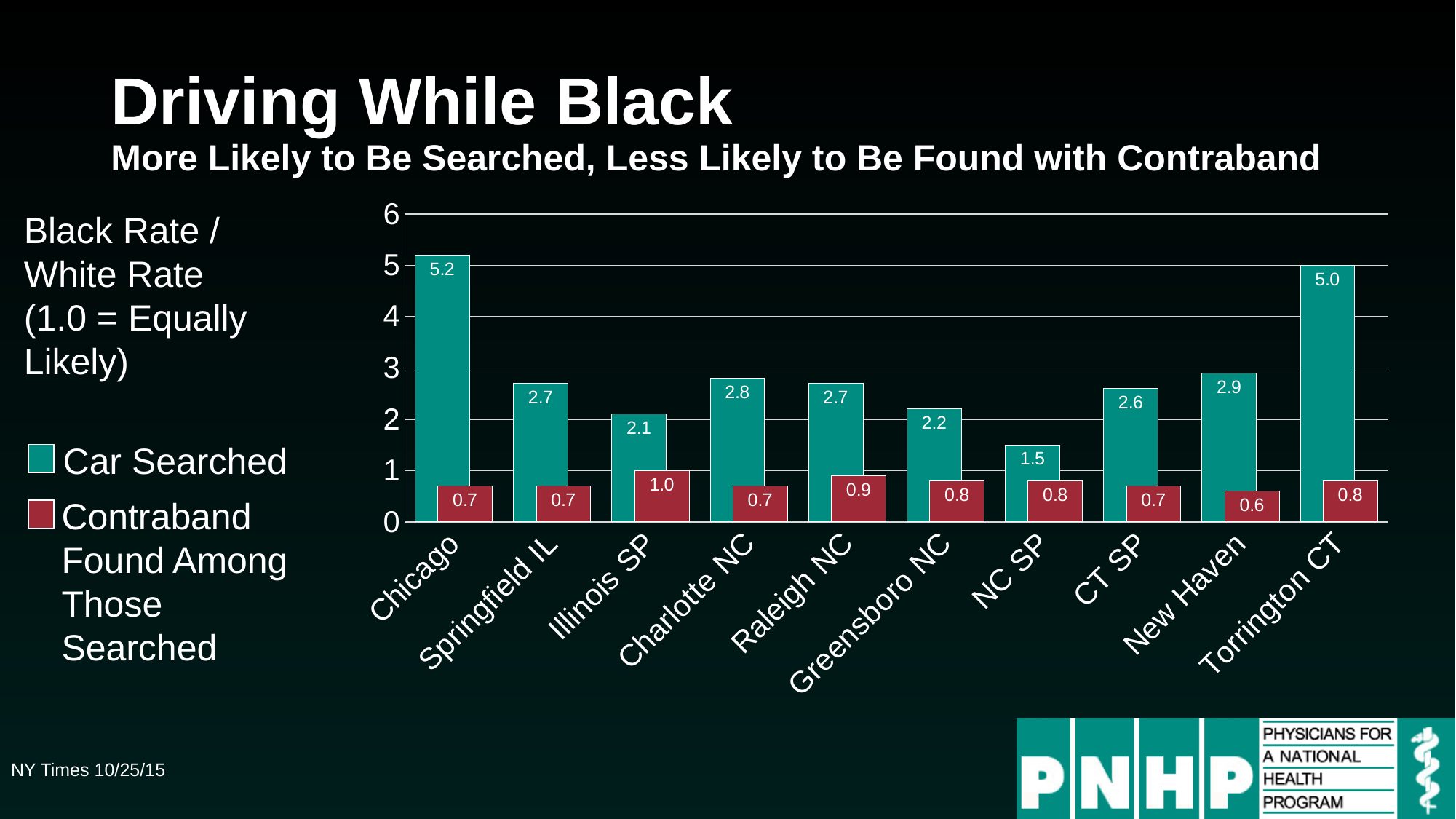
What is the Car Searched value for Chicago? 5.2 Which category has the lowest Contraband Found Among Those Searched value? New Haven Which category has the highest Car Searched value? Chicago What is the Car Searched value for New Haven? 2.9 Which category has the lowest Car Searched value? NC SP Which is larger, the Car Searched value for Charlotte NC or for Raleigh NC? Charlotte NC What is the difference between the Car Searched values for Chicago and Torrington CT? 0.2 How many series does the legend list? 2 What colour are the Car Searched bars? teal What is the Contraband Found Among Those Searched value for Illinois SP? 1.0 What kind of chart is shown on the slide? bar chart How many categories are shown on the x axis? 10